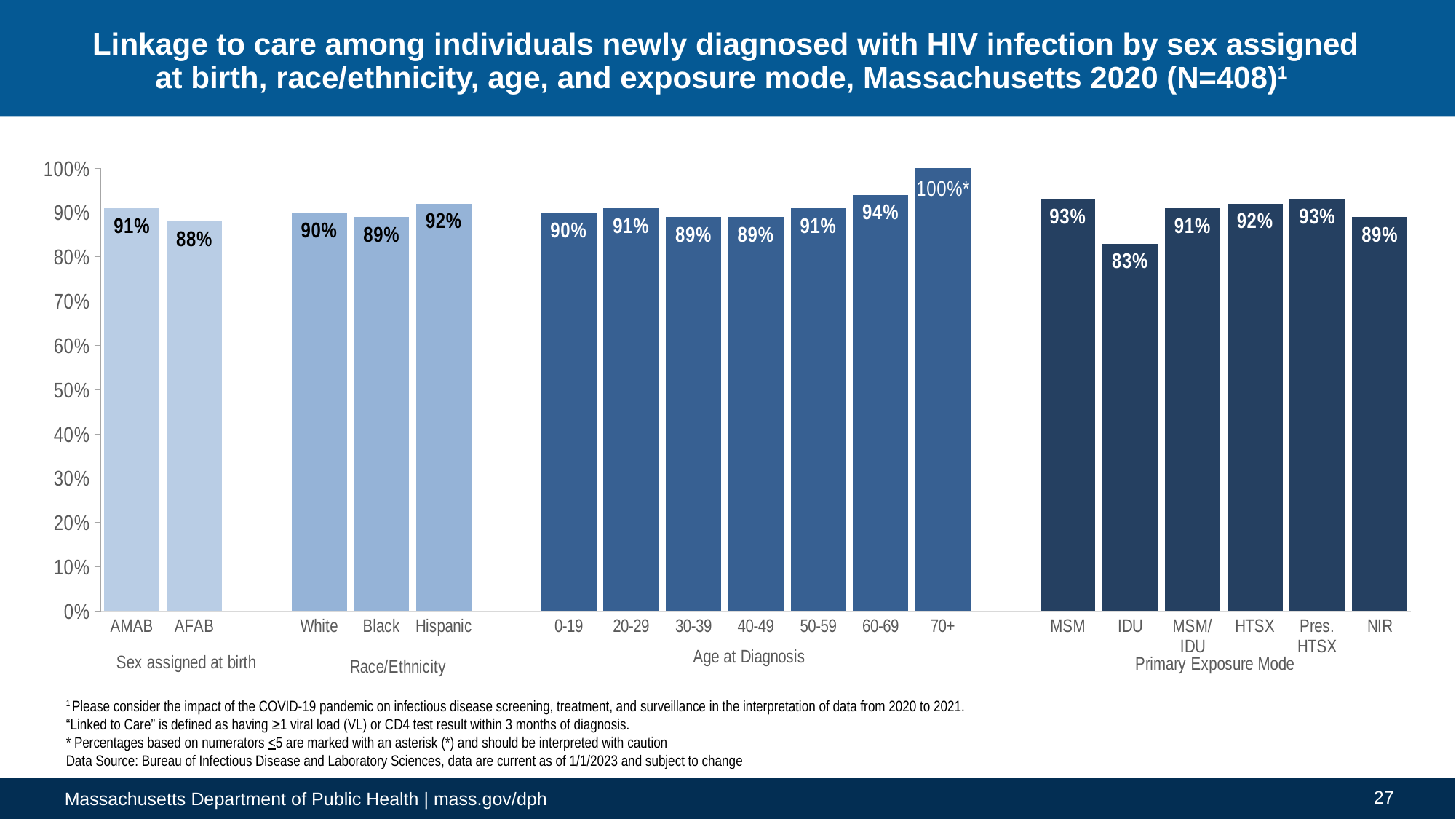
Which category has the lowest linkage to care percentage on the chart? IDU Which age group has the highest linkage to care percentage? 70+ What is the linkage to care percentage for Hispanic individuals? 92% Which has a higher linkage to care percentage, White or Black? White What is the difference in linkage to care between MSM and IDU? 10% What is the linkage to care percentage for the 60-69 age group? 94% What is the linkage to care percentage for IDU? 83% What is the difference in linkage to care between AMAB and AFAB? 3% What type of chart is shown on the slide? Bar chart What is the linkage to care percentage for AFAB? 88% How many bars are plotted on the chart in total? 18 Which value on the chart is marked with an asterisk? 100%* (70+)